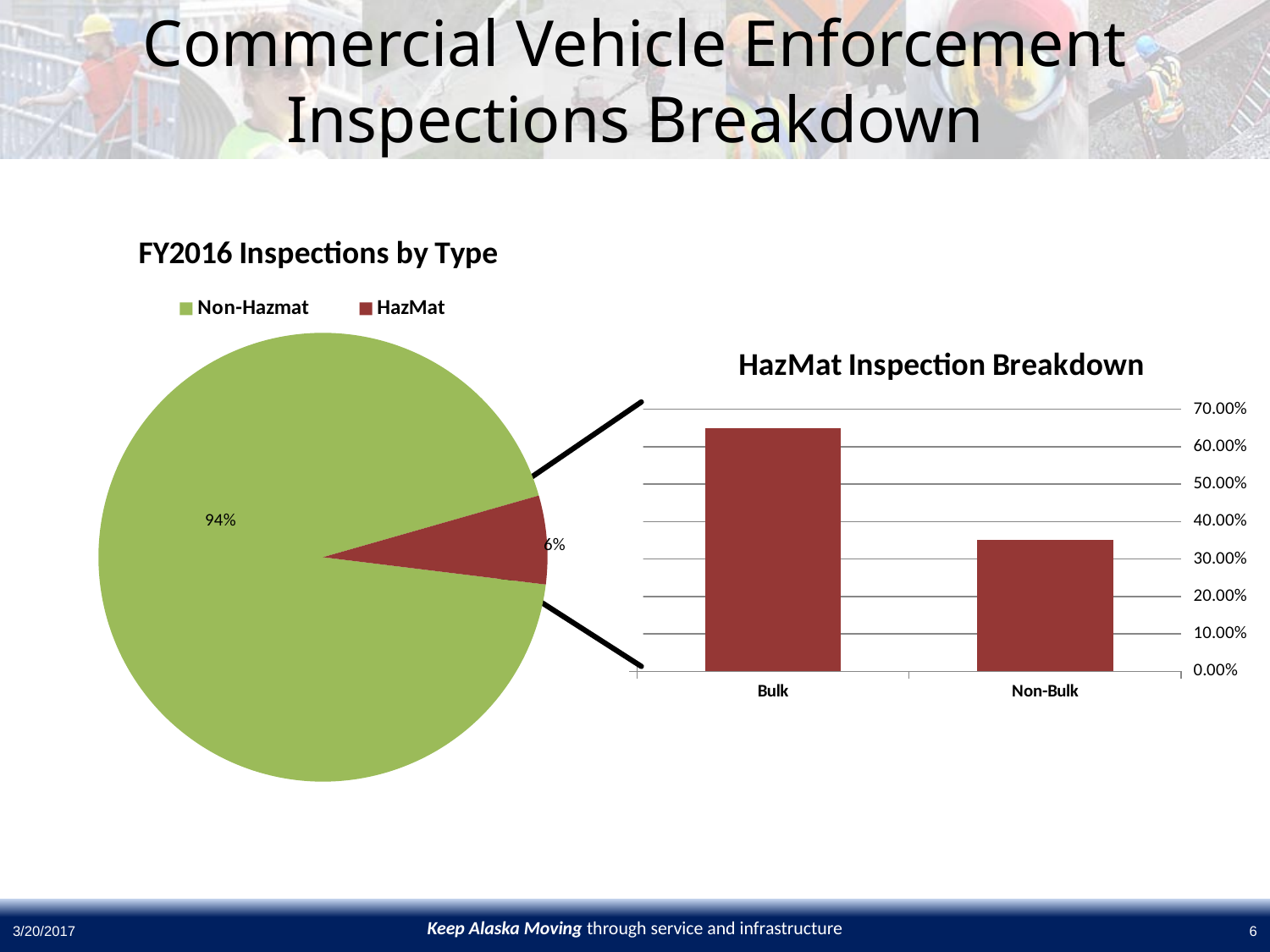
In the FY2016 Inspections by Type chart, which category has the smallest slice? HazMat In the FY2016 Inspections by Type chart, which category has the largest slice? Non-Hazmat What kind of chart is the HazMat Inspection Breakdown chart? Bar chart In the FY2016 Inspections by Type chart, what is the difference in percentage points between the Non-Hazmat and HazMat slices? 88 In the HazMat Inspection Breakdown chart, which category has the higher value? Bulk What kind of chart is the FY2016 Inspections by Type chart? Pie chart In the FY2016 Inspections by Type chart, what share of inspections is HazMat? 6% How many entries does the legend of the FY2016 Inspections by Type chart list? 2 In the HazMat Inspection Breakdown chart, is the value for Non-Bulk greater or less than 40.00%? less How many categories are shown on the x axis of the HazMat Inspection Breakdown chart? 2 In the HazMat Inspection Breakdown chart, is the value for Bulk greater or less than 60.00%? greater In the FY2016 Inspections by Type chart, what share of inspections is Non-Hazmat? 94%